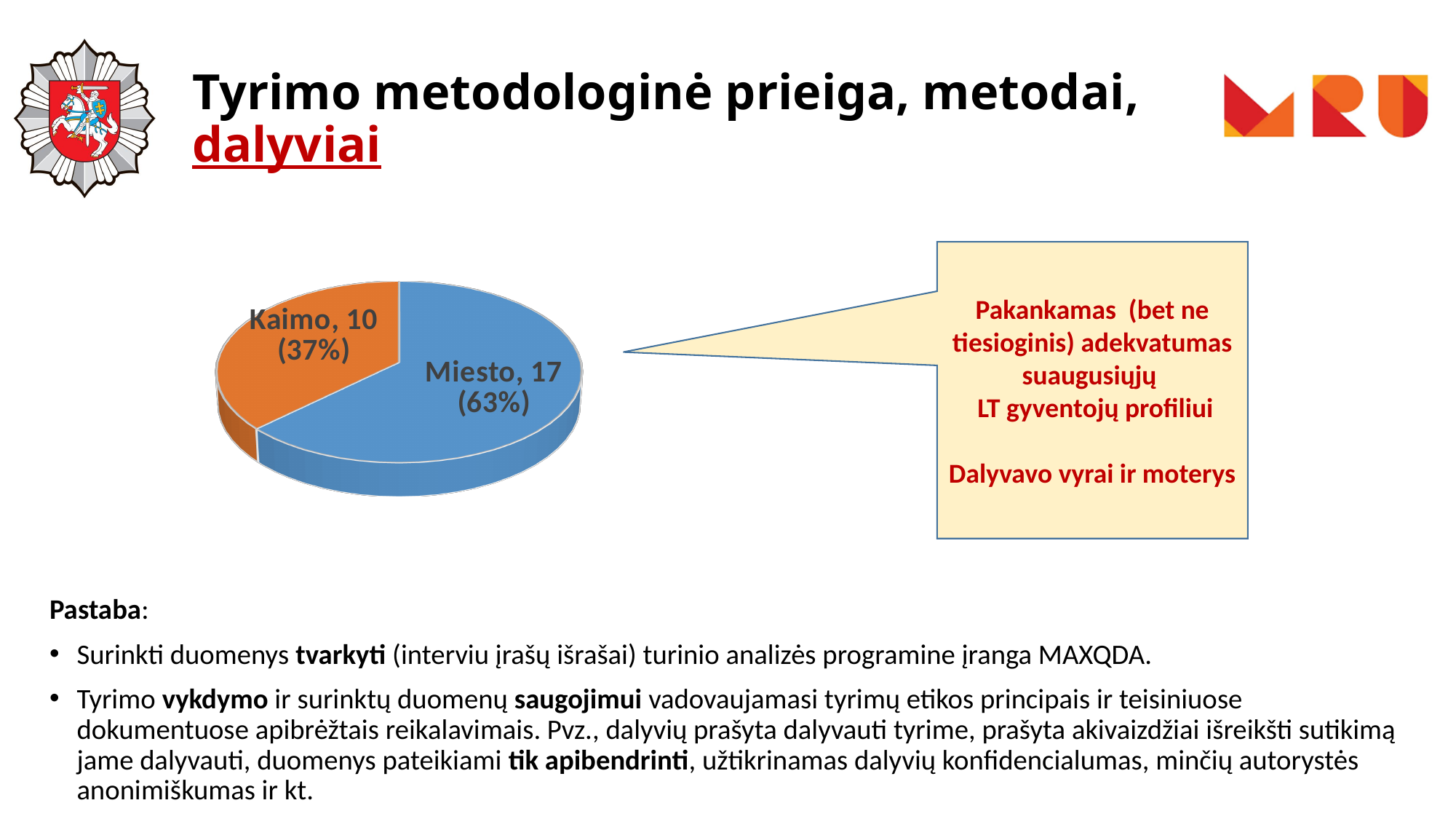
What is the value for Kaimo in the pie chart? 10 Which slice of the pie chart is the smallest? Kaimo What is the total of the two slices in the pie chart? 27 What is the value for Miesto in the pie chart? 17 What is the difference between the Miesto and Kaimo values? 7 What kind of chart is shown on the slide? pie chart What share of the pie does the Miesto slice represent? 63% Which is larger, the Miesto value or the Kaimo value? Miesto What colour is the Kaimo slice in the pie chart? orange What share of the pie does the Kaimo slice represent? 37% Which slice of the pie chart is the largest? Miesto How many slices does the pie chart have? 2